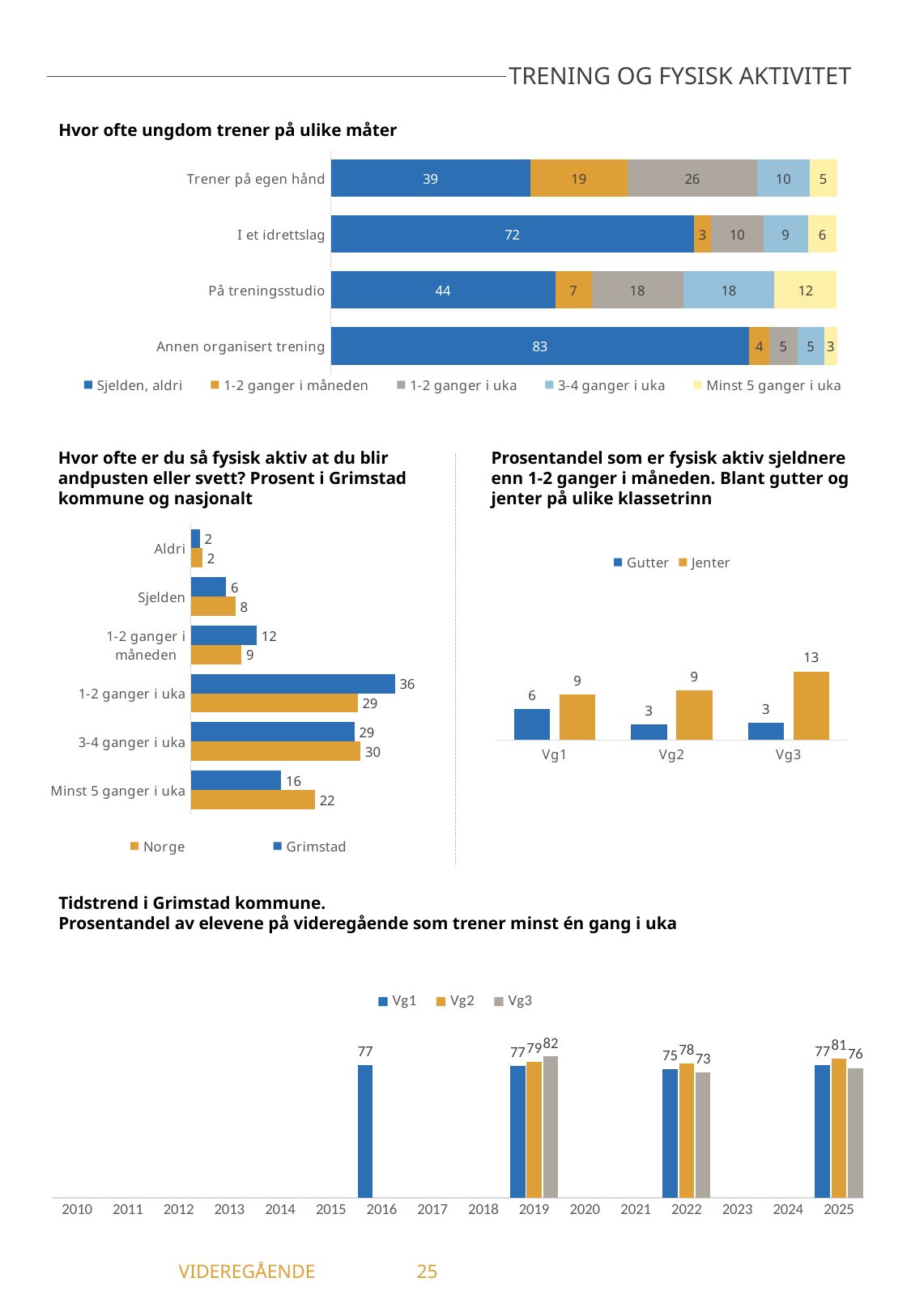
What kind of chart is 'Tidstrend i Grimstad kommune'? Bar chart In the chart 'Hvor ofte er du så fysisk aktiv at du blir andpusten eller svett?', how many categories are shown? 6 In the chart 'Hvor ofte ungdom trener på ulike måter', how many series does the legend list? 5 In the chart 'Hvor ofte ungdom trener på ulike måter', what is the value for 'Sjelden, aldri' for 'I et idrettslag'? 72 In the chart 'Hvor ofte ungdom trener på ulike måter', which category has the highest value for 'Sjelden, aldri'? Annen organisert trening In the chart 'Prosentandel som er fysisk aktiv sjeldnere enn 1-2 ganger i måneden', which is larger at Vg1, Gutter or Jenter? Jenter In the chart 'Hvor ofte er du så fysisk aktiv at du blir andpusten eller svett?', what is the Grimstad value for '1-2 ganger i uka'? 36 In the chart 'Tidstrend i Grimstad kommune', which year has the lowest Vg3 value? 2022 In the chart 'Hvor ofte er du så fysisk aktiv at du blir andpusten eller svett?', what is the difference between the Norge and Grimstad values for 'Minst 5 ganger i uka'? 6 In the chart 'Hvor ofte ungdom trener på ulike måter', what is the total of the stacked bar for 'På treningsstudio'? 99 In the chart 'Prosentandel som er fysisk aktiv sjeldnere enn 1-2 ganger i måneden', what is the value for Jenter at Vg3? 13 In the chart 'Tidstrend i Grimstad kommune', what is the Vg3 value for 2019? 82